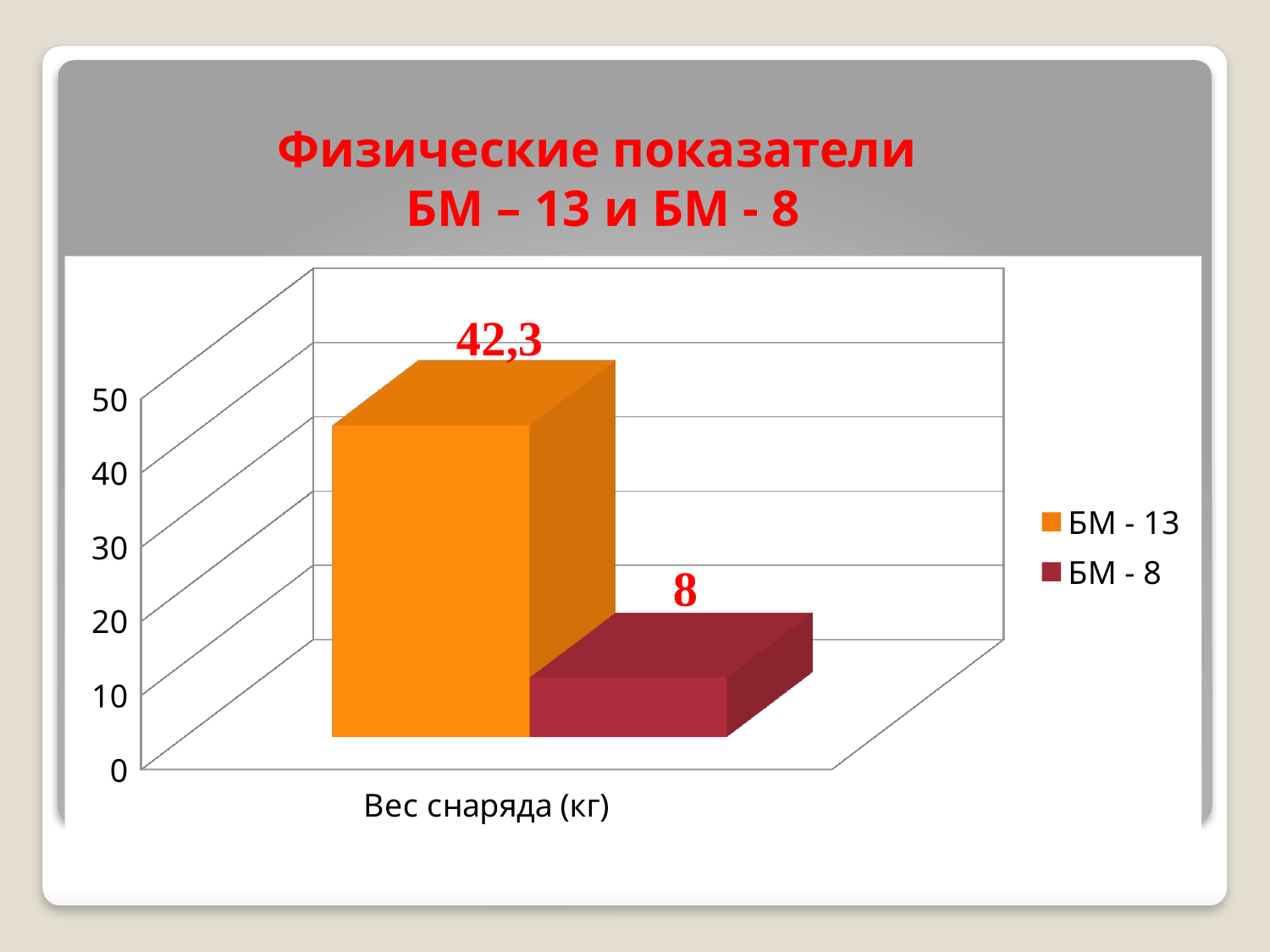
What is the value for БМ - 8 in the chart? 8 Which series has the lowest value in the chart? БМ - 8 Which series has the higher value, БМ - 13 or БМ - 8? БМ - 13 Is the value for БМ - 13 greater or less than 40? greater What colour is the bar for БМ - 13? orange What is the difference between the values for БМ - 13 and БМ - 8? 34,3 Is the value for БМ - 8 greater or less than 10? less What is the value for БМ - 13 in the chart? 42,3 What is the label on the x axis of the chart? Вес снаряда (кг) What kind of chart is shown on the slide? bar chart How many series does the legend list? 2 How many categories are shown on the x axis? 1